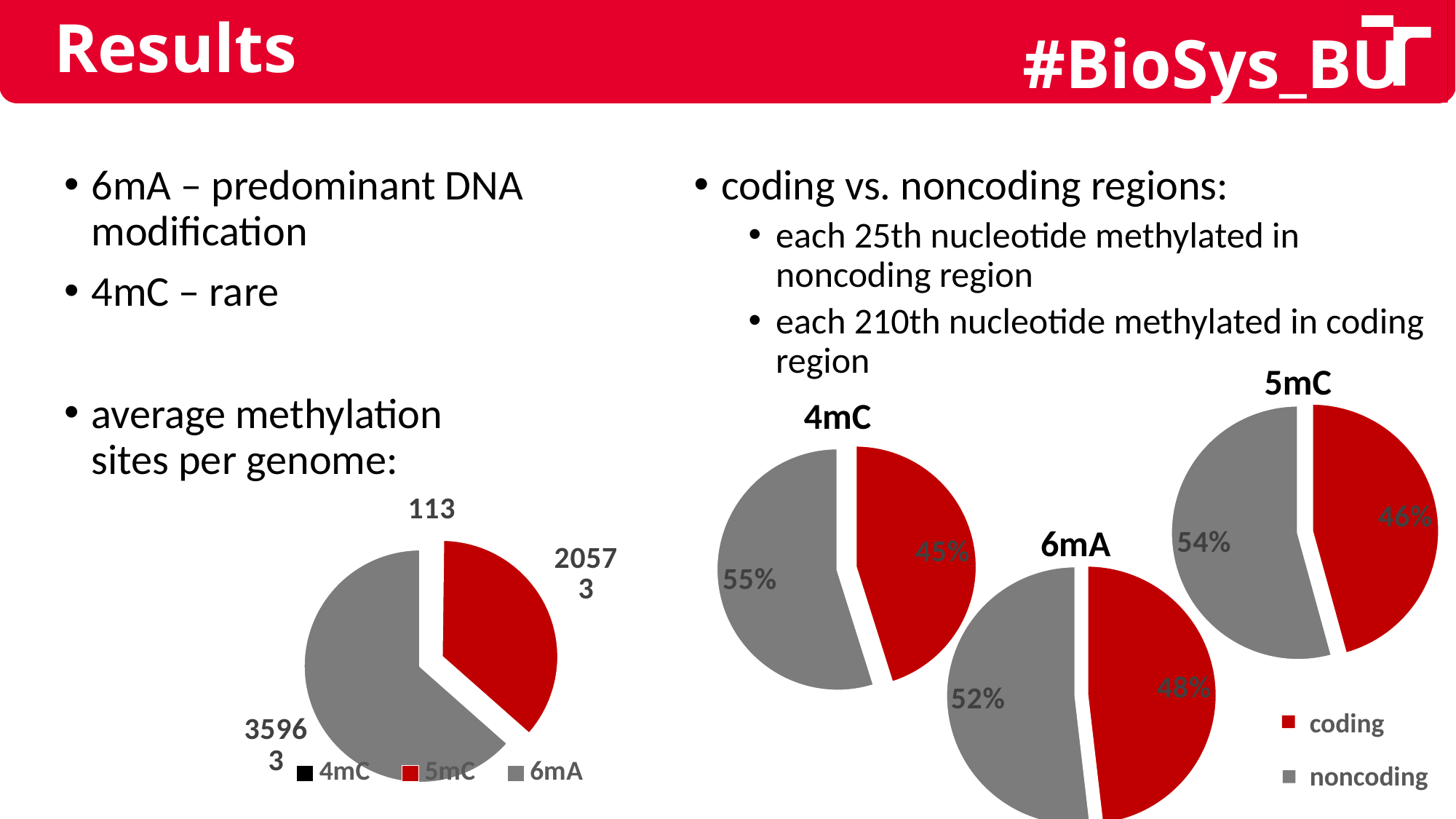
In the 4mC pie chart on the right, what share is noncoding? 55% How many categories does the 'average methylation sites per genome' pie chart on the left show? 3 In the 6mA pie chart on the right, what share is coding? 48% In the 4mC pie chart on the right, what share is coding? 45% In the 'average methylation sites per genome' pie chart on the left, what is the value for 4mC? 113 In the 5mC pie chart on the right, which is larger, the coding or the noncoding share? noncoding In the 'average methylation sites per genome' pie chart on the left, what is the value for 5mC? 20573 In the 6mA pie chart on the right, by how many percentage points does the noncoding share exceed the coding share? 4 percentage points In the 'average methylation sites per genome' pie chart on the left, which modification has the largest number of sites? 6mA In the 'average methylation sites per genome' pie chart on the left, which modification has the smallest number of sites? 4mC What kind of chart is used for 'average methylation sites per genome' on the left of the slide? Pie chart